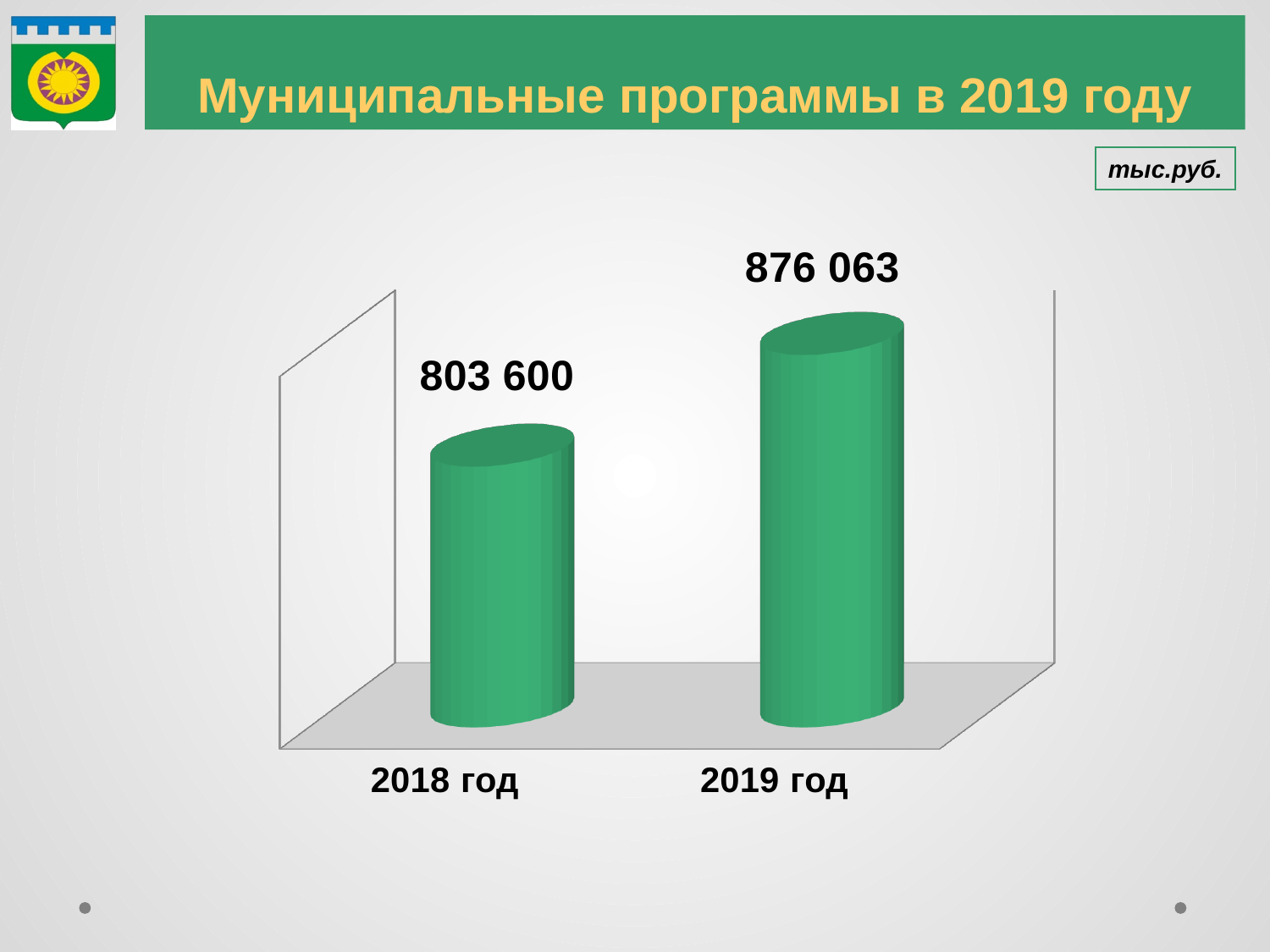
What is the value for 2018 год? 803 600 Do the values rise or fall from 2018 год to 2019 год? Rise What kind of chart is shown on the slide? Bar chart What is the difference between the values for 2019 год and 2018 год? 72 463 How many categories are shown in the chart? 2 Which year has the highest value? 2019 год Which is larger, the value for 2018 год or the value for 2019 год? 2019 год What is the title of the slide containing the chart? Муниципальные программы в 2019 году In what units are the chart values given? тыс.руб. Which year has the lowest value? 2018 год What is the value for 2019 год? 876 063